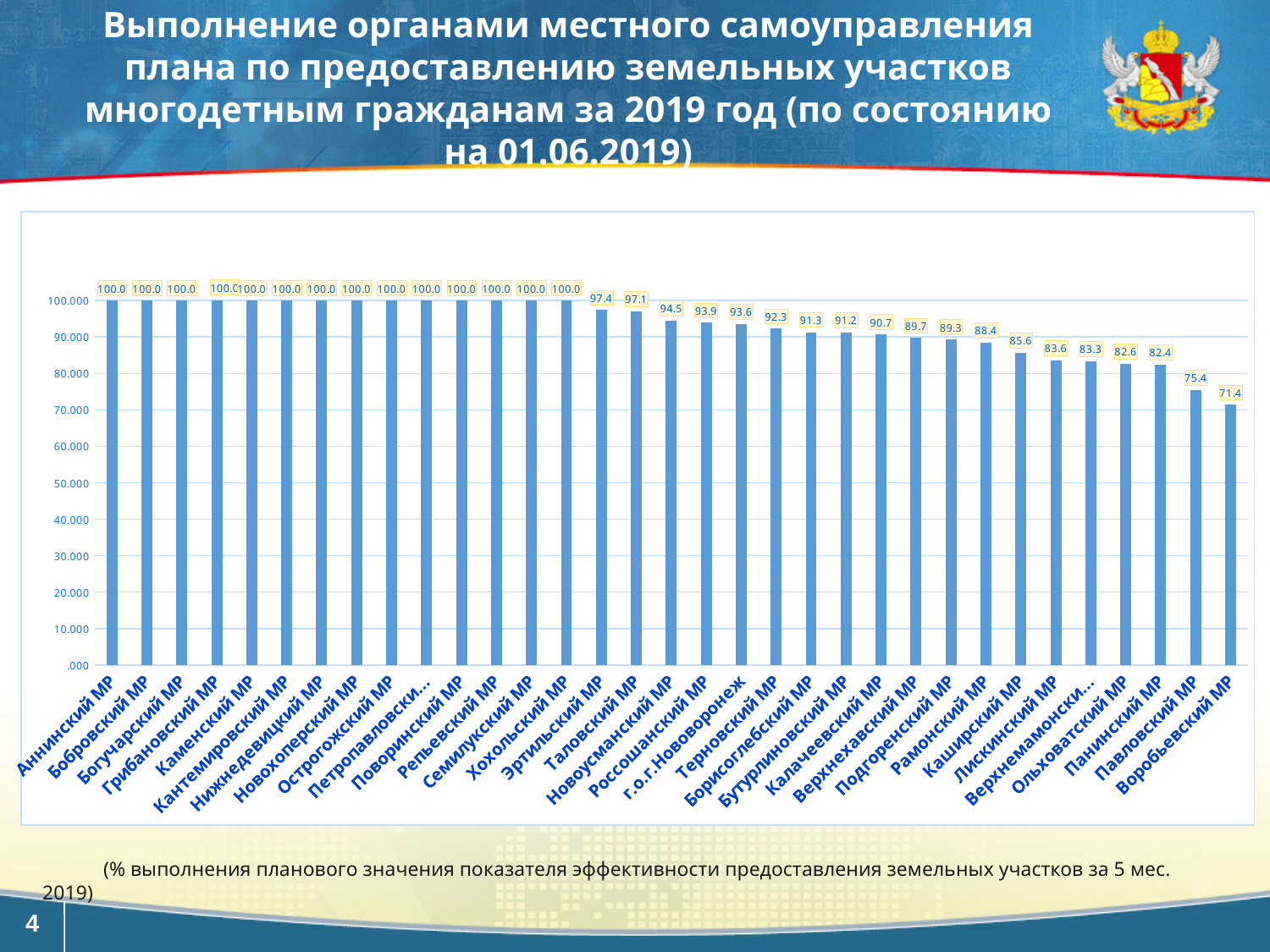
Do the values generally rise or fall from left to right along the x axis? fall Is the value for Павловский МР greater or less than 80.000? less What is the difference between the values for Павловский МР and Воробьевский МР? 4.0 Which is larger, the value for Терновский МР or the value for Калачеевский МР? Терновский МР What is the difference between the values for Аннинский МР and Рамонский МР? 11.6 What type of chart is shown on the slide? bar chart What is the value for г.о.г.Нововоронеж? 93.6 Which category has the lowest value? Воробьевский МР What is the value for Воробьевский МР? 71.4 What is the value for Каширский МР? 85.6 How many categories are plotted on the chart? 33 What is the value for Эртильский МР? 97.4